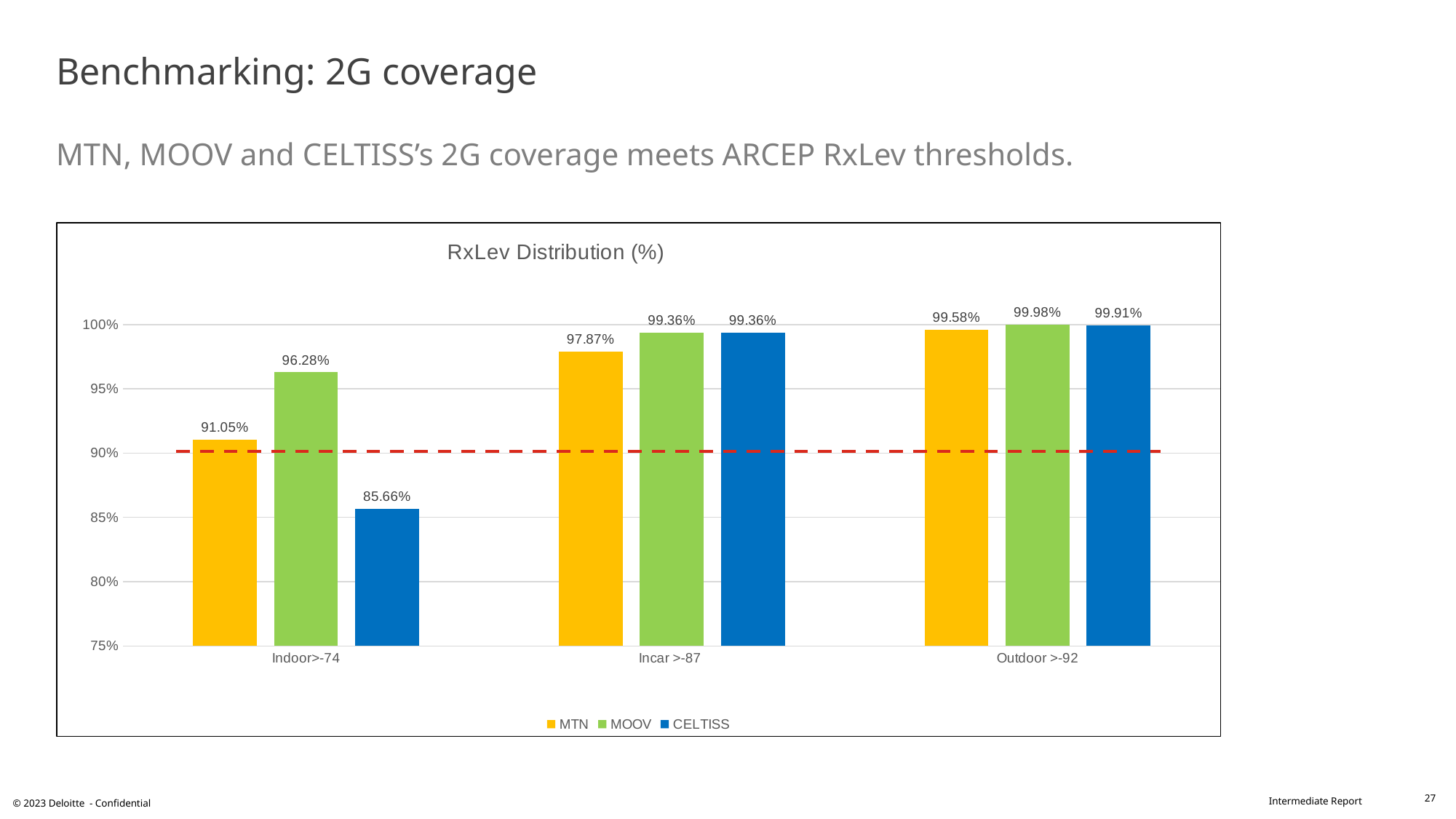
Which operator has the lowest value in the Indoor>-74 category? CELTISS Is the value for CELTISS in the Indoor>-74 category greater or less than 90%? less Which operator has the highest value in the Indoor>-74 category? MOOV What is the value for MOOV in the Outdoor >-92 category? 99.98% What is the value for CELTISS in the Indoor>-74 category? 85.66% How many categories are shown on the x axis? 3 What is the value for MTN in the Incar >-87 category? 97.87% Which is larger in the Incar >-87 category: MTN or MOOV? MOOV How many series does the legend list? 3 What kind of chart is shown on the slide? Bar chart What is the difference between MOOV and CELTISS in the Indoor>-74 category? 10.62% What is the value for MTN in the Indoor>-74 category? 91.05%